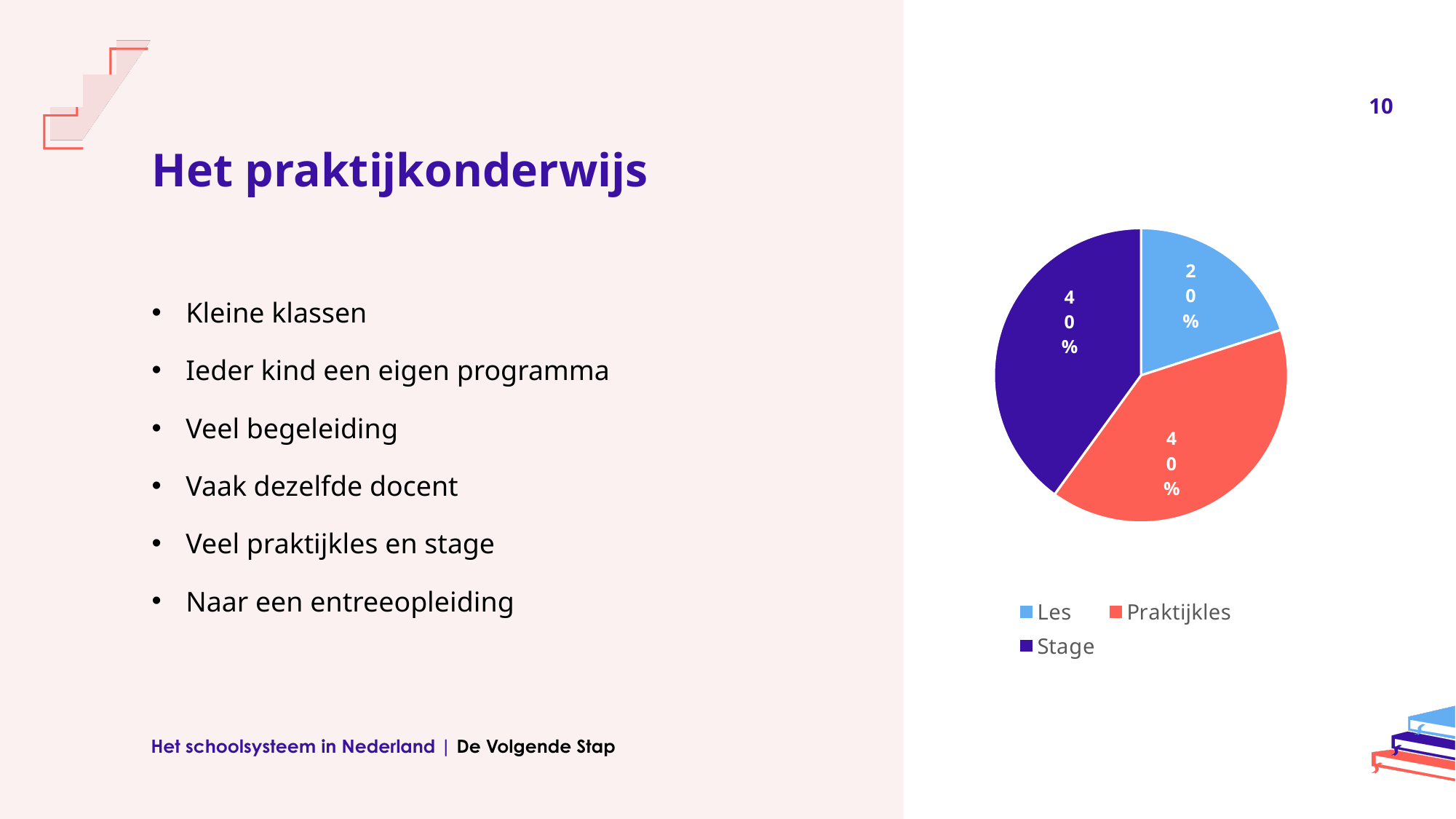
Which is larger in the pie chart, Praktijkles or Les? Praktijkles How many slices does the pie chart have? 3 Which category has the smallest slice in the pie chart? Les What is the difference in percentage points between the Stage slice and the Les slice? 20 What share of the pie does Les represent? 20% What are the three entries listed in the chart legend? Les, Praktijkles, Stage Which is larger in the pie chart, Stage or Les? Stage What percentage does the Stage slice show in the pie chart? 40% What kind of chart is shown on the slide? Pie chart What colour is the Stage slice in the pie chart? Dark purple What percentage does the Praktijkles slice show in the pie chart? 40% What percentage does the Les slice show in the pie chart? 20%